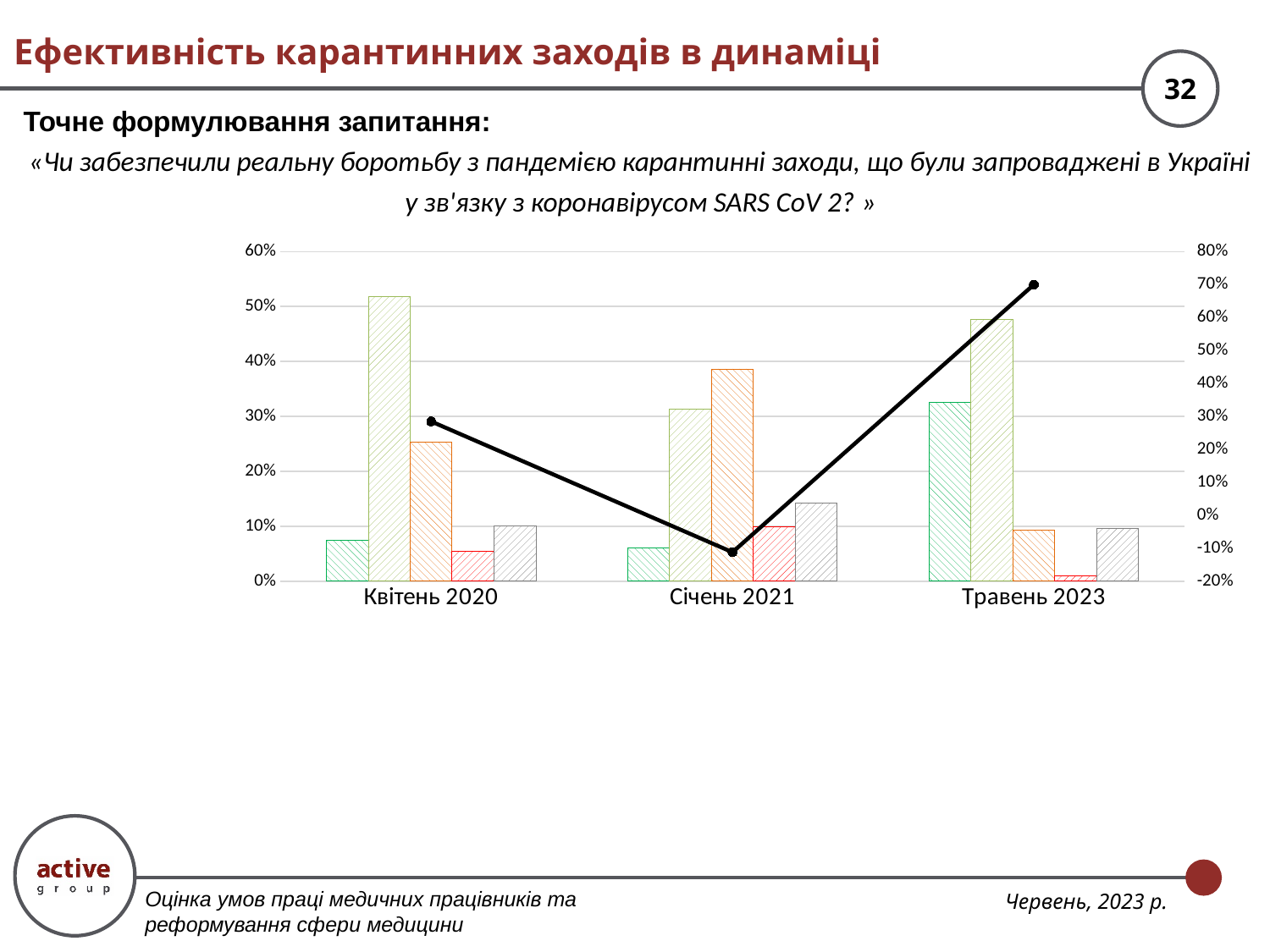
How many categories are shown on the x axis of the chart? 3 Is the black line value for Квітень 2020 larger or smaller than the black line value for Травень 2023? smaller Which category has the lowest value on the black line? Січень 2021 Is the black line value for Травень 2023 greater or less than 60% on the right axis? greater Is the black line value for Квітень 2020 greater or less than 20% on the right axis? greater Is the black line value for Січень 2021 greater or less than 0% on the right axis? less Which category has the highest value on the black line? Травень 2023 What is the maximum value shown on the left vertical axis of the chart? 60% How many bars are plotted for each category in the chart? 5 What kind of chart is shown on the slide? A bar chart combined with a line Does the black line rise or fall from Квітень 2020 to Січень 2021? fall